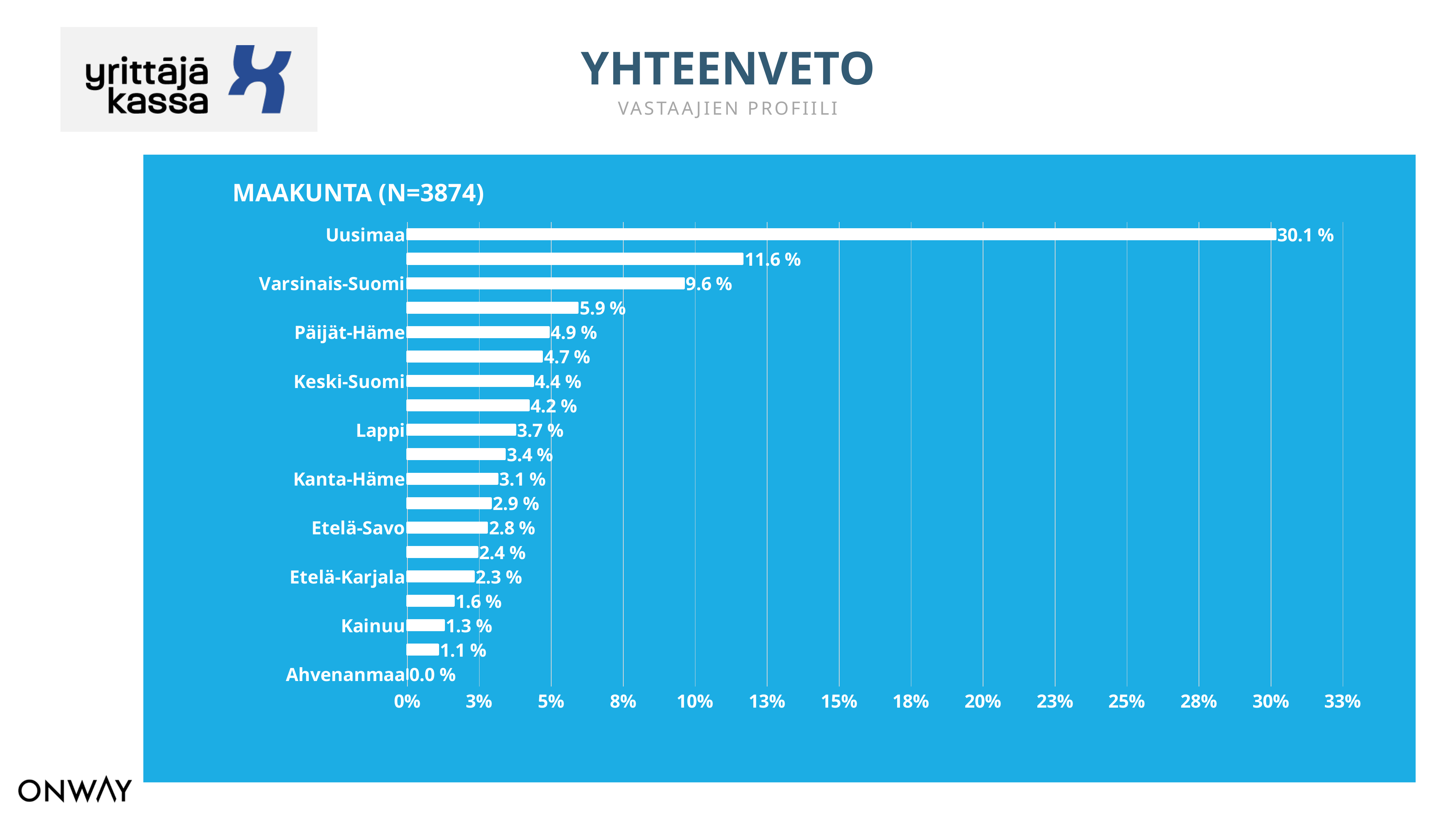
What is the title of the chart? MAAKUNTA (N=3874) What is the value for Ahvenanmaa? 0.0 % What kind of chart is shown on the slide? Bar chart What is the difference between the values for Uusimaa and Varsinais-Suomi? 20.5 % Which region has the lowest value? Ahvenanmaa What is the value for Uusimaa? 30.1 % What is the value for Varsinais-Suomi? 9.6 % What is the value for Lappi? 3.7 % Which is larger, the value for Päijät-Häme or the value for Keski-Suomi? Päijät-Häme What is the difference between the values for Etelä-Savo and Etelä-Karjala? 0.5 % Which region has the highest value? Uusimaa What is the value for Kainuu? 1.3 %